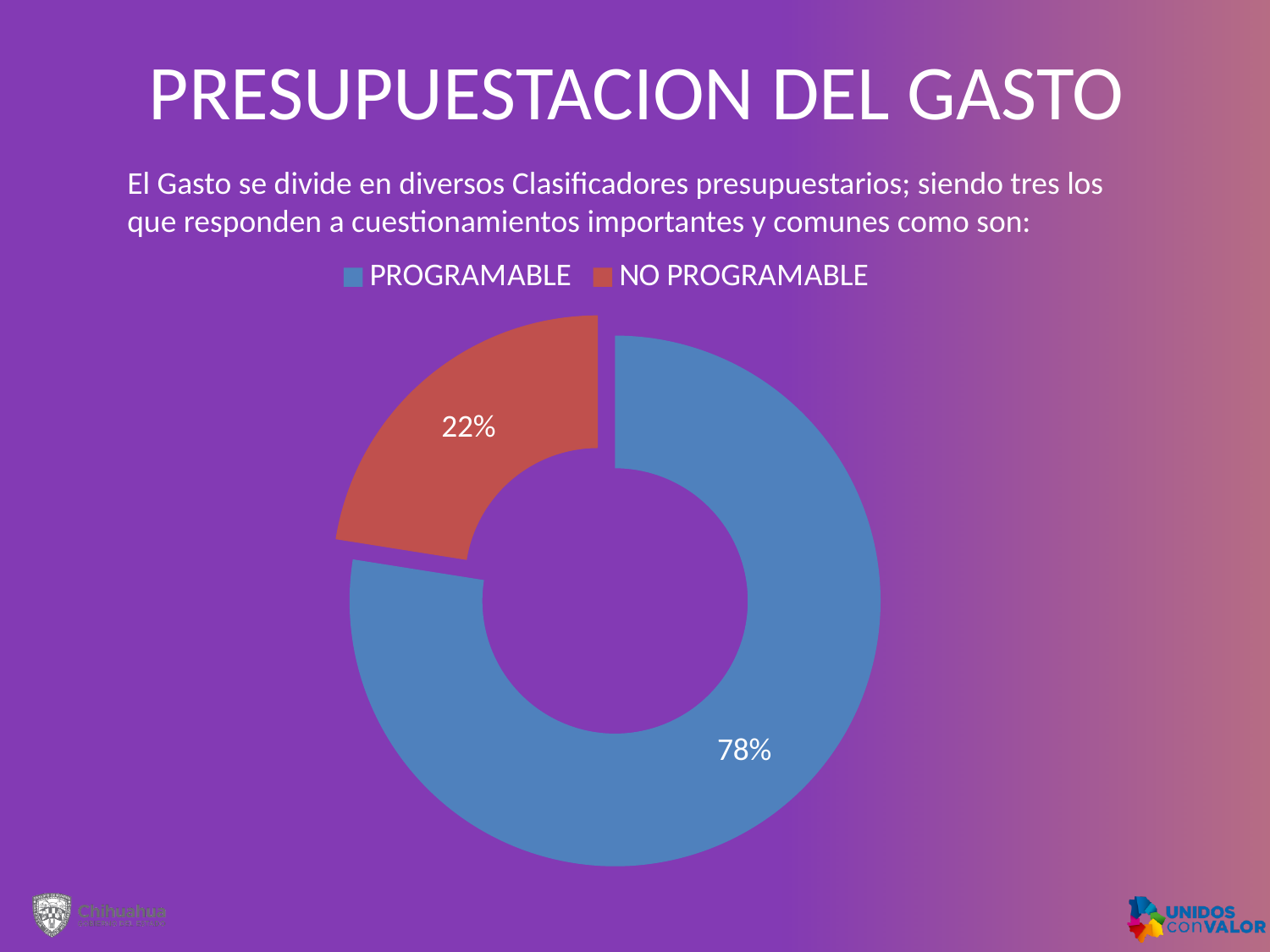
Which category has the smallest share of the chart? NO PROGRAMABLE What share of the chart does PROGRAMABLE represent? 78% Which is larger, the share for PROGRAMABLE or the share for NO PROGRAMABLE? PROGRAMABLE Which category has the largest share of the chart? PROGRAMABLE What colour is the NO PROGRAMABLE slice? Red What colour is the PROGRAMABLE slice? Blue What share of the chart does NO PROGRAMABLE represent? 22% What is the difference in percentage points between PROGRAMABLE and NO PROGRAMABLE? 56 How many entries does the legend list? 2 How many categories does the chart show? 2 What kind of chart is shown on the slide? Doughnut (pie) chart What is the total of the two slices shown in the chart? 100%